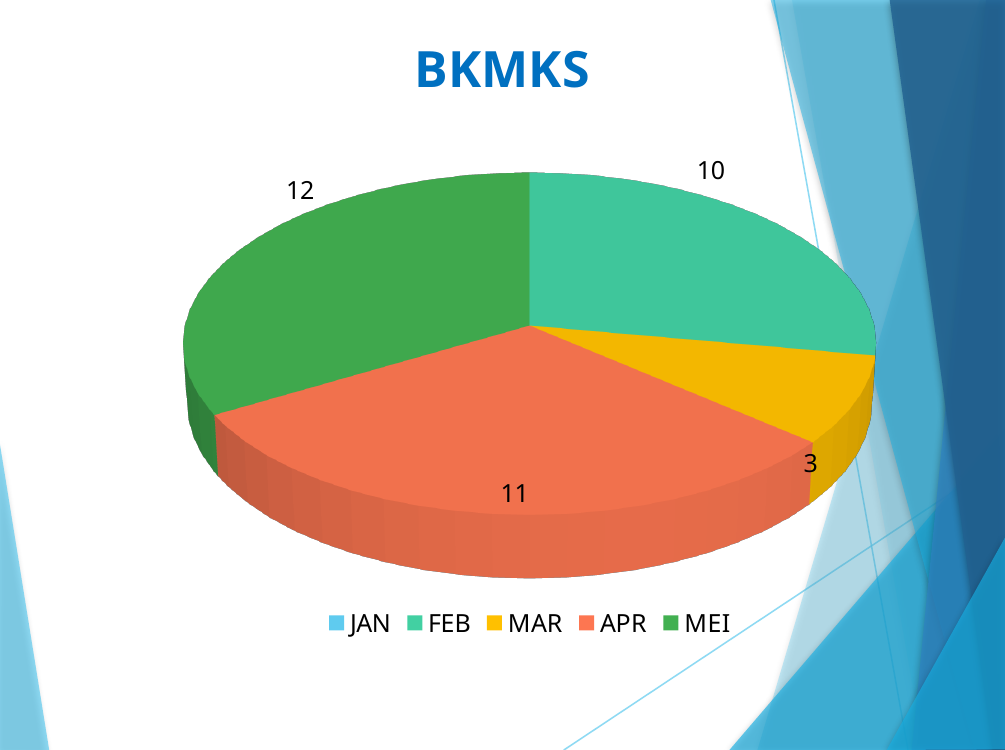
What kind of chart is shown on the slide? Pie chart What is the value of the MAR slice? 3 What is the difference between the APR value and the FEB value? 1 What is the title of the chart? BKMKS What is the value of the APR slice? 11 Which labelled slice has the largest value? MEI Which labelled slice has the smallest value? MAR Which is larger, the APR slice or the FEB slice? APR What is the value of the MEI slice? 12 What is the value of the FEB slice? 10 What is the difference between the MEI value and the MAR value? 9 How many entries does the legend list? 5